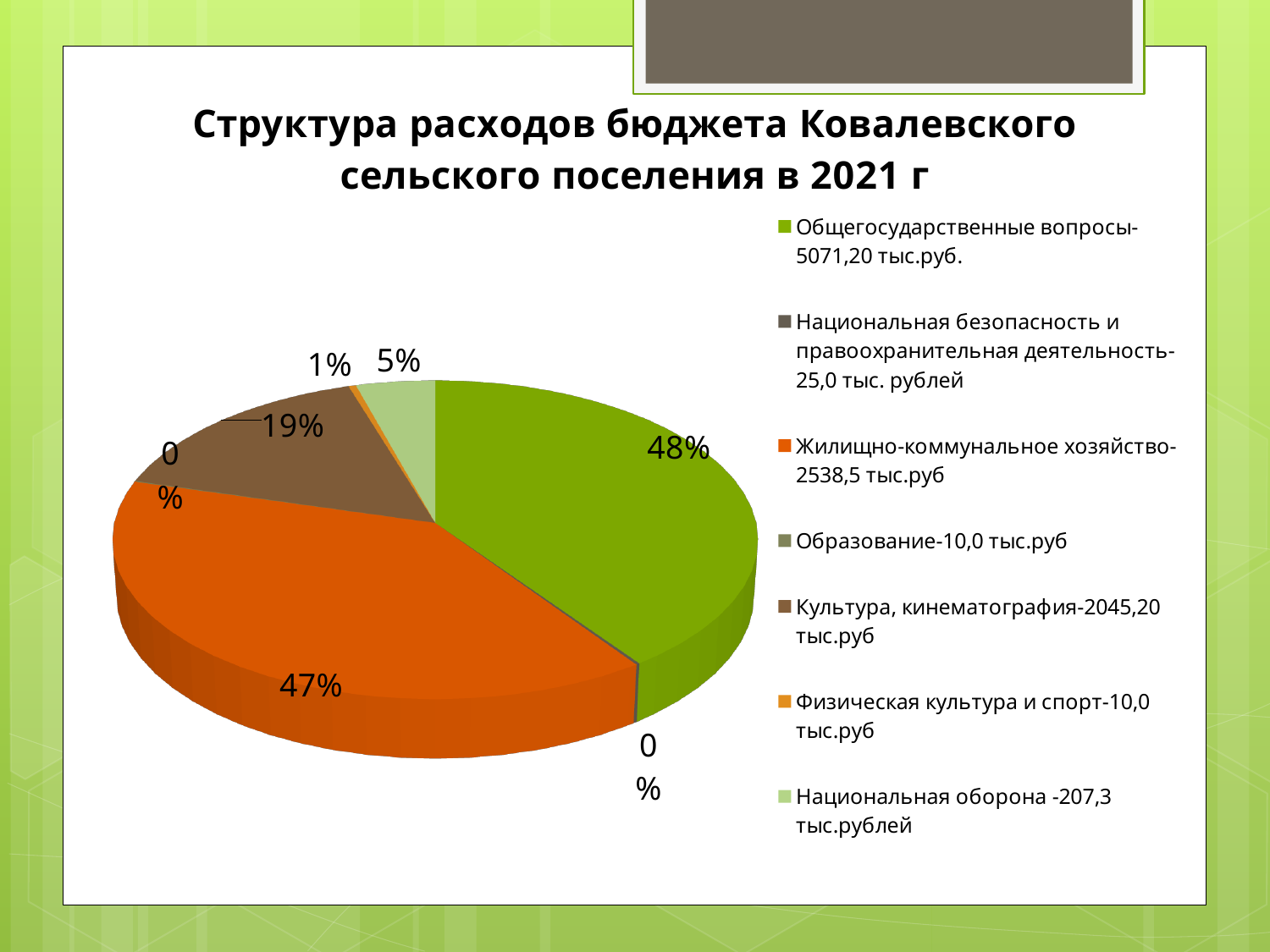
What share of the pie does Физическая культура и спорт take? 1% How many entries does the legend list? 7 What amount in тыс.руб. is listed in the legend for Культура, кинематография? 2045,20 тыс.руб What kind of chart is shown on the slide? pie chart What share of the pie does Общегосударственные вопросы take? 48% What is the title of the chart? Структура расходов бюджета Ковалевского сельского поселения в 2021 г What share of the pie does Жилищно-коммунальное хозяйство take? 47% What amount is listed in the legend for Национальная безопасность и правоохранительная деятельность? 25,0 тыс. рублей Which is larger: the share for Культура, кинематография or the share for Национальная оборона? Культура, кинематография Which category has the largest share of the pie? Общегосударственные вопросы